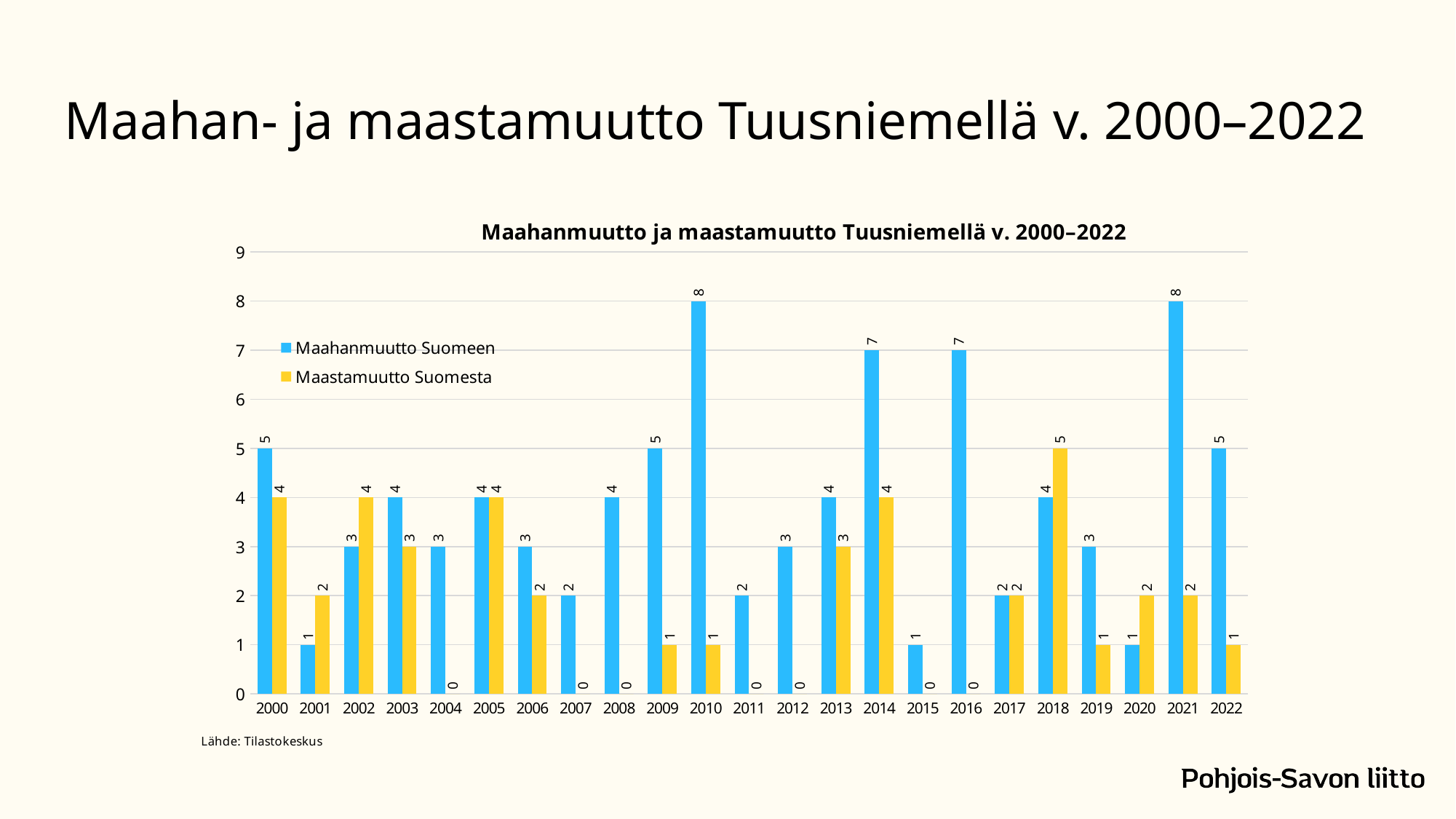
What is the difference between Maahanmuutto Suomeen in 2021 and in 2022? 3 What is the value of Maahanmuutto Suomeen in 2010? 8 What is the value of Maahanmuutto Suomeen in 2016? 7 What kind of chart is shown on the slide? Bar chart What is the value of Maastamuutto Suomesta in 2004? 0 In which year is Maastamuutto Suomesta highest? 2018 Which is larger in 2009, Maahanmuutto Suomeen or Maastamuutto Suomesta? Maahanmuutto Suomeen Which is larger in 2002, Maahanmuutto Suomeen or Maastamuutto Suomesta? Maastamuutto Suomesta How many series does the legend list? 2 What is the difference between Maahanmuutto Suomeen and Maastamuutto Suomesta in 2014? 3 What is the value of Maastamuutto Suomesta in 2018? 5 How many years are shown on the x axis of the chart? 23